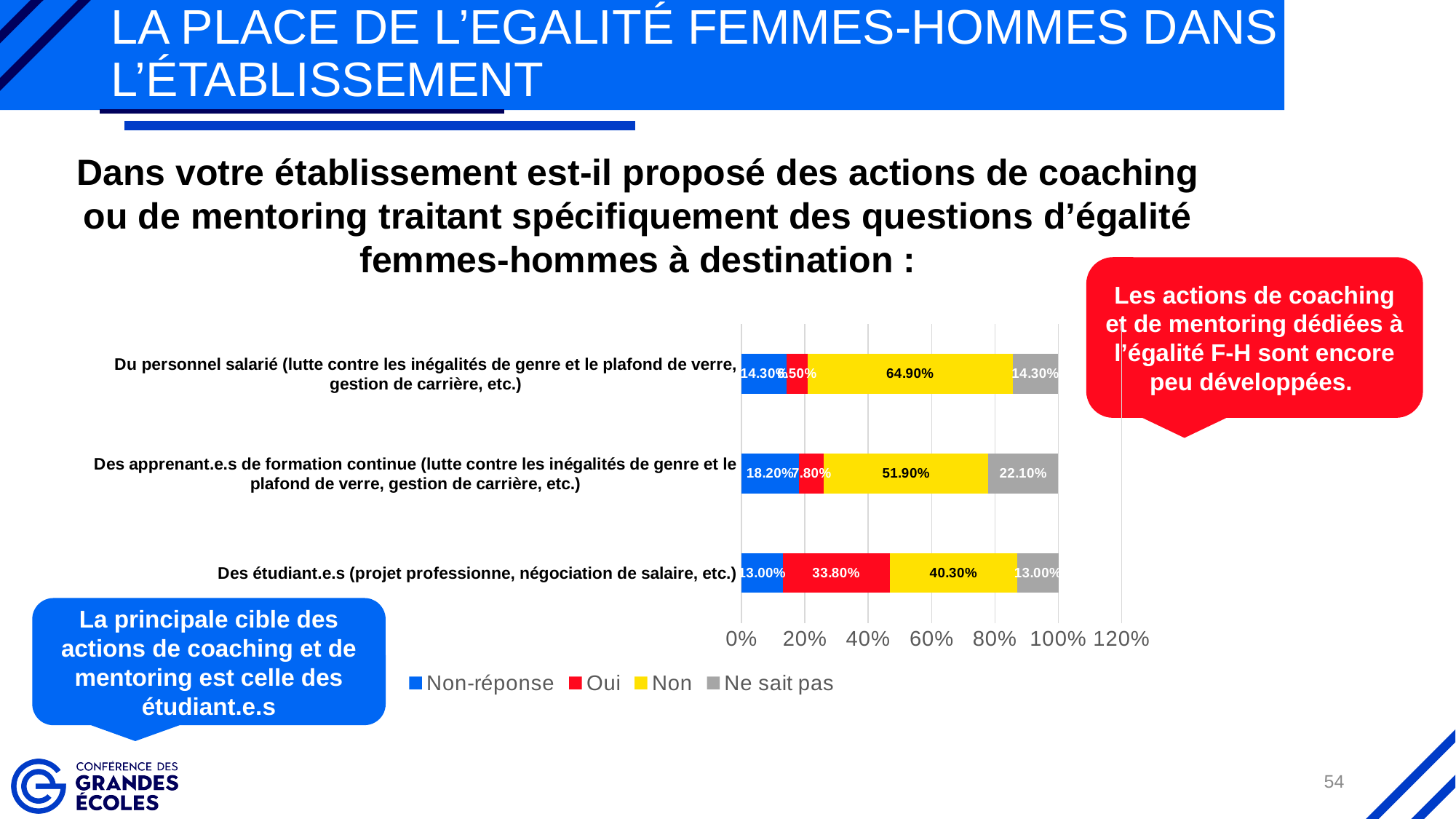
How many categories (target groups) are plotted in the chart? 3 What is the 'Non' value for 'Du personnel salarié'? 64.90% For 'Des étudiant.e.s', what is the difference between the 'Non' value and the 'Oui' value? 6.50% What kind of chart is shown on the slide? Stacked bar chart What are the four legend entries of the chart? Non-réponse, Oui, Non, Ne sait pas How many series does the legend list? 4 Which category has the larger 'Ne sait pas' value: 'Du personnel salarié' or 'Des apprenant.e.s de formation continue'? Des apprenant.e.s de formation continue Which category has the highest 'Non' value? Du personnel salarié What is the 'Ne sait pas' value for 'Des apprenant.e.s de formation continue'? 22.10% Which category has the highest 'Oui' value? Des étudiant.e.s (projet professionne, négociation de salaire, etc.) What is the 'Oui' value for 'Des étudiant.e.s (projet professionne, négociation de salaire, etc.)'? 33.80% What is the 'Non-réponse' value for 'Des apprenant.e.s de formation continue'? 18.20%